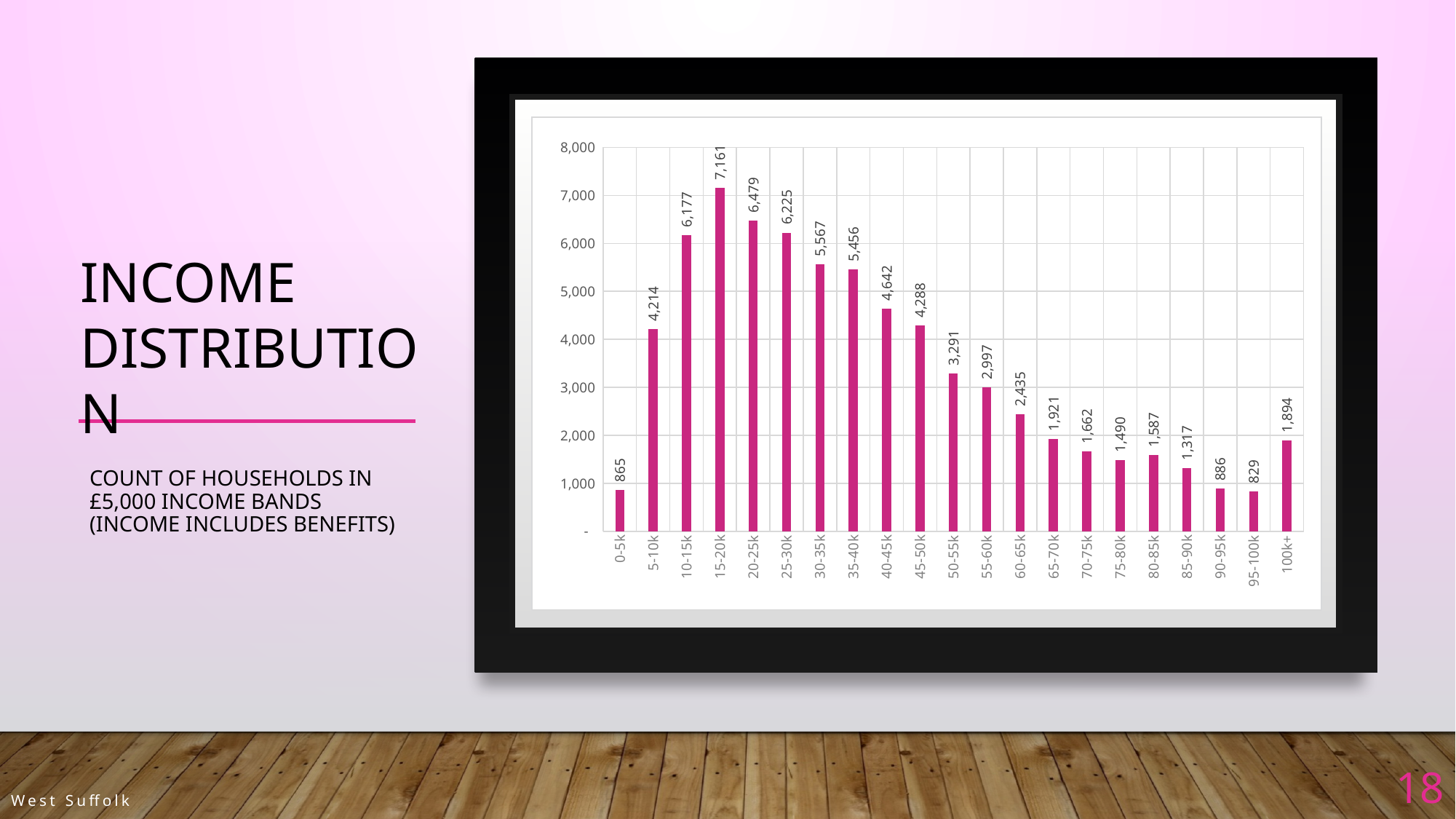
Which income band has more households, 20-25k or 25-30k? 20-25k What is the count of households in the 0-5k income band? 865 What is the count of households in the 15-20k income band? 7,161 Which income band has the lowest count of households? 95-100k What kind of chart is shown on the slide? Bar chart How many income bands are shown on the chart? 21 What is the count of households in the 100k+ income band? 1,894 What is the count of households in the 50-55k income band? 3,291 What is the difference between the household counts for the 100k+ and 95-100k bands? 1,065 Which income band has the highest count of households? 15-20k What is the difference between the household counts for the 15-20k and 0-5k bands? 6,296 Is the value for the 60-65k band greater or less than 3,000? less